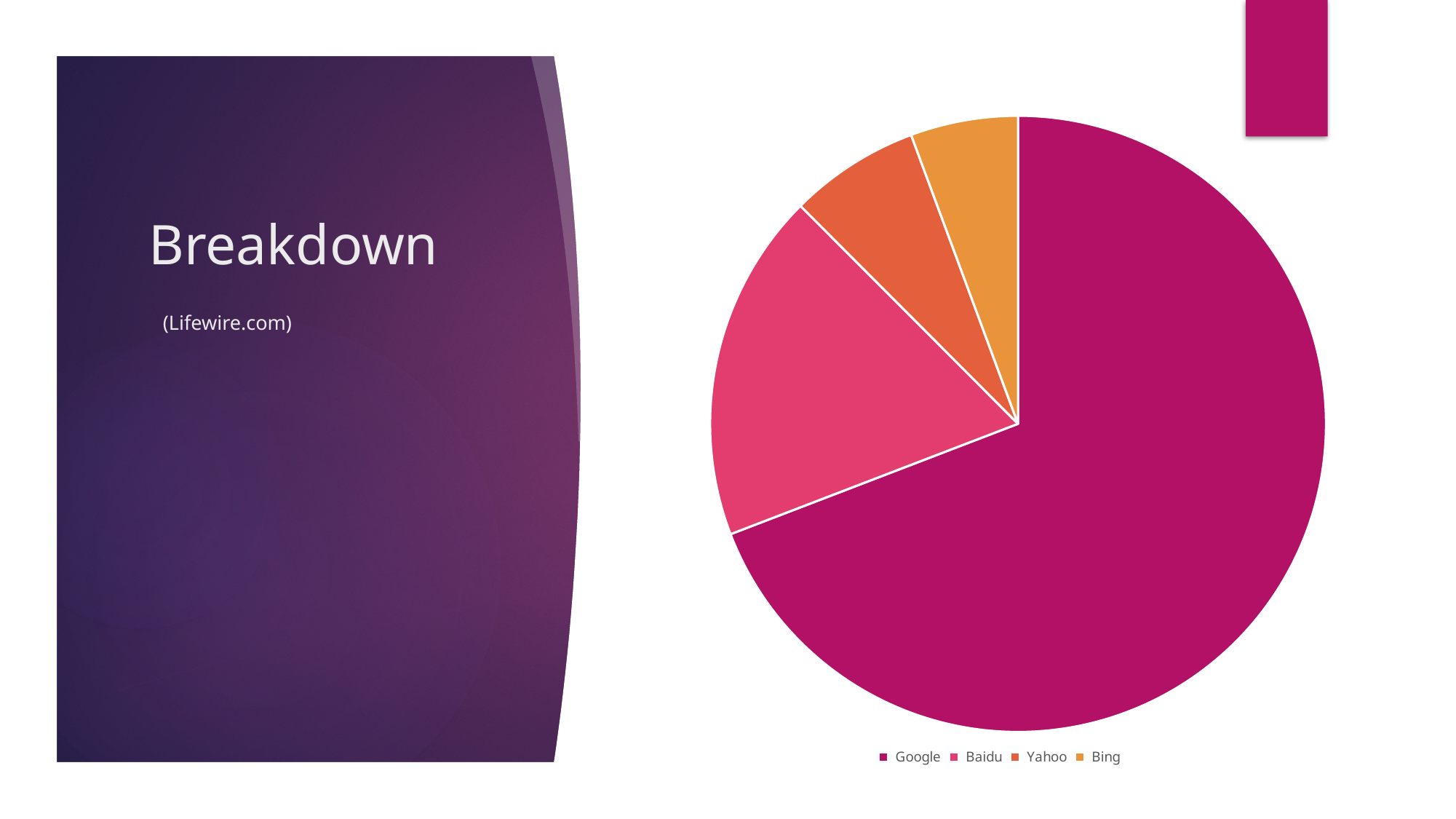
Which slice is larger in the pie chart, Google or Baidu? Google Which category has the smallest slice in the pie chart? Bing How many entries does the legend of the pie chart list? 4 Which category has the largest slice in the pie chart? Google How many slices does the pie chart have? 4 What are the categories listed in the pie chart's legend, in order? Google, Baidu, Yahoo, Bing What kind of chart is shown on the slide? pie chart Which category has the second-largest slice in the pie chart? Baidu Which slice is larger in the pie chart, Baidu or Bing? Baidu Which slice is larger in the pie chart, Baidu or Yahoo? Baidu Where is the legend positioned relative to the pie chart? below the chart